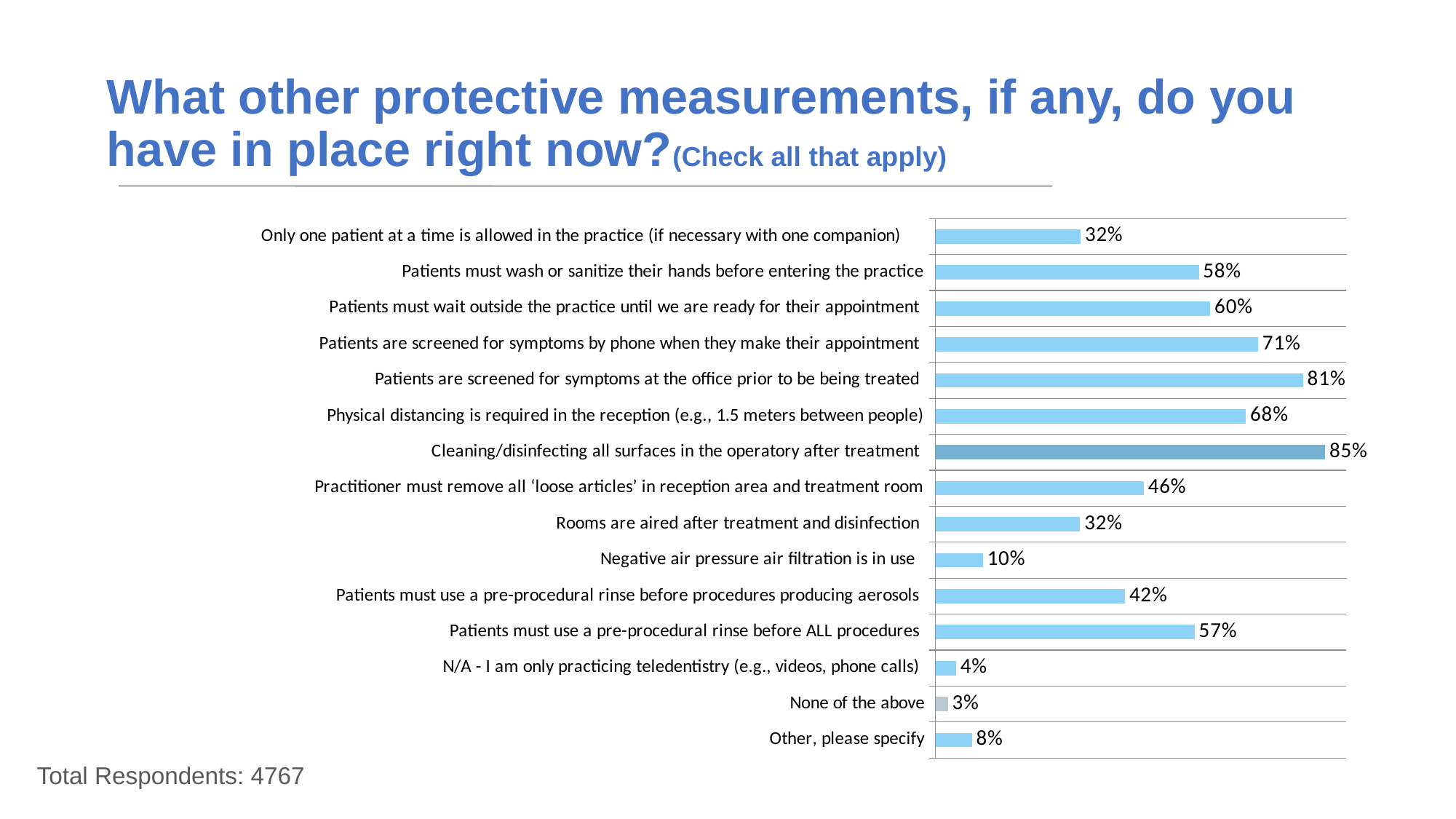
Which bar is shown in a darker blue colour than the others? Cleaning/disinfecting all surfaces in the operatory after treatment How many categories are shown in the chart? 15 How many total respondents are reported on the slide? 4767 What percentage of respondents reported that patients are screened for symptoms by phone when they make their appointment? 71% Which protective measure has the highest percentage? Cleaning/disinfecting all surfaces in the operatory after treatment What is the value for 'Negative air pressure air filtration is in use'? 10% What type of chart is shown on the slide? Bar chart Which is larger: 'Patients must wash or sanitize their hands before entering the practice' or 'Patients must wait outside the practice until we are ready for their appointment'? Patients must wait outside the practice until we are ready for their appointment Which category has the lowest percentage? None of the above What is the difference between 'Patients are screened for symptoms at the office prior to be being treated' and 'Patients are screened for symptoms by phone when they make their appointment'? 10% What is the difference between 'Practitioner must remove all 'loose articles' in reception area and treatment room' and 'Patients must use a pre-procedural rinse before procedures producing aerosols'? 4% What percentage selected 'Patients must use a pre-procedural rinse before ALL procedures'? 57%